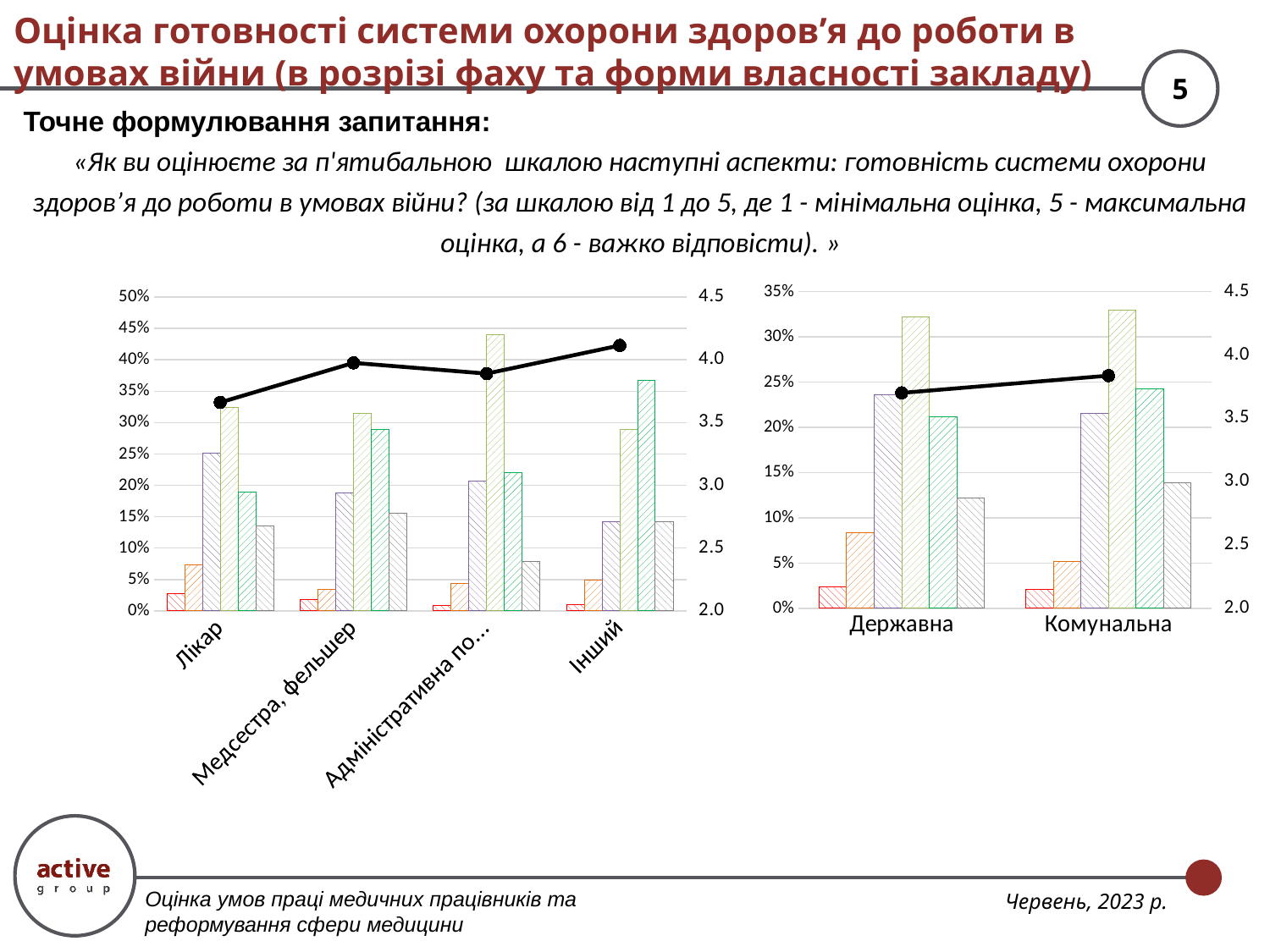
In the right chart, does the black line rise or fall from Державна to Комунальна? rise In the left chart, how many categories are shown on the x axis? 4 In the right chart, is the black line value for Державна greater or less than 4.0? less In the right chart, is the black line value for Комунальна greater or less than 3.5? greater In the right chart, how many categories are shown on the x axis? 2 In the left chart, which category has the highest value on the black line? Інший In the right chart, which category has the higher value on the black line, Державна or Комунальна? Комунальна What kind of chart is the right chart? bar chart combined with a line chart In the left chart, is the black line value for Лікар greater or less than 4.0? less In the left chart, which category has the lowest value on the black line? Лікар